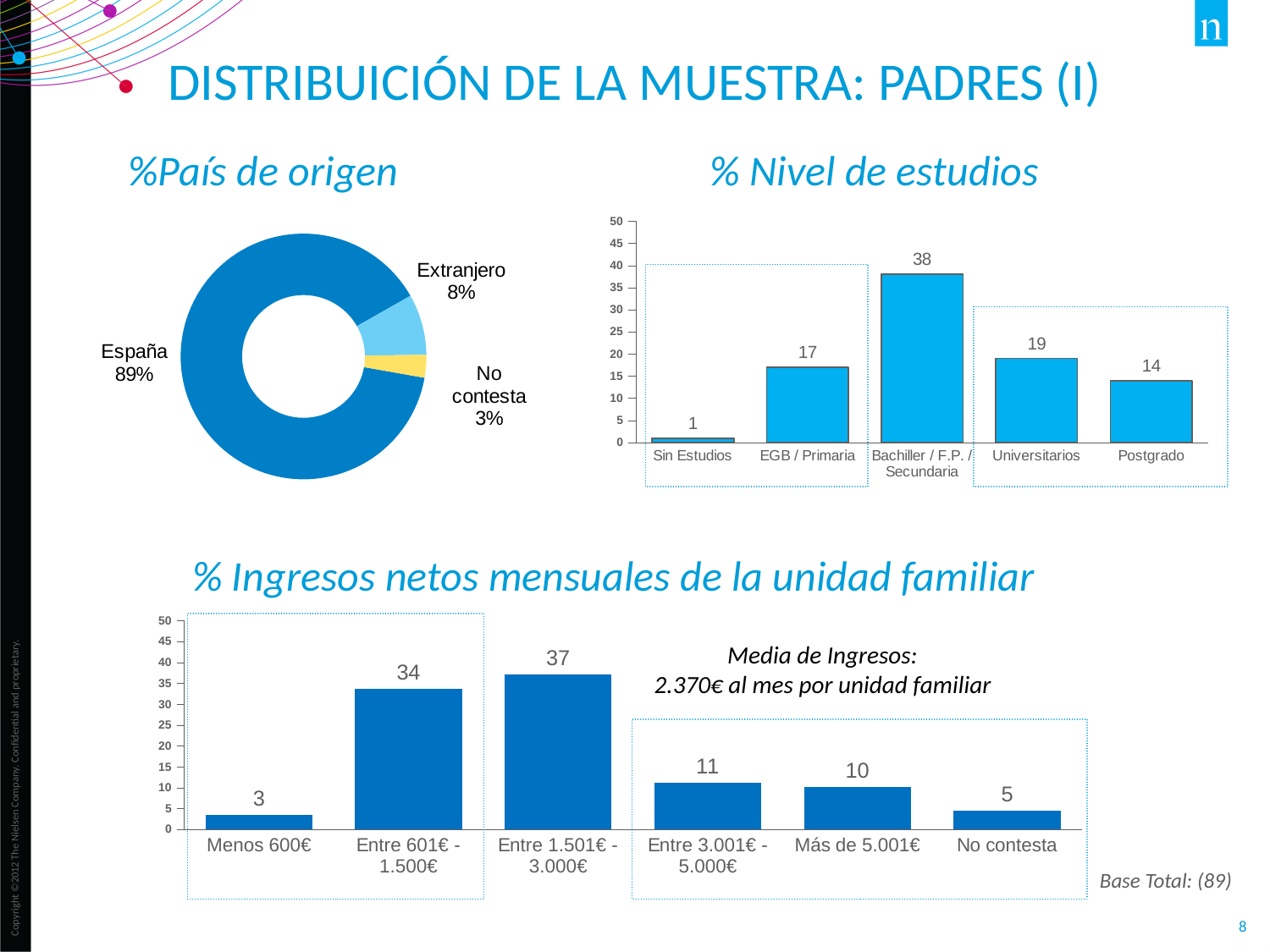
In the '% Nivel de estudios' chart, which category has the lowest value? Sin Estudios In the '% Ingresos netos mensuales de la unidad familiar' chart, which category has the highest value? Entre 1.501€ - 3.000€ What kind of chart is the '% Ingresos netos mensuales de la unidad familiar' chart? Bar chart In the '%País de origen' chart, what share does Extranjero have? 8% In the '% Nivel de estudios' chart, what is the value for Bachiller / F.P. / Secundaria? 38 In the '%País de origen' chart, what share does España have? 89% In the '% Ingresos netos mensuales de la unidad familiar' chart, what is the difference between Entre 1.501€ - 3.000€ and Entre 601€ - 1.500€? 3 What kind of chart is the '%País de origen' chart? Doughnut (pie) chart In the '% Ingresos netos mensuales de la unidad familiar' chart, which is larger: Menos 600€ or No contesta? No contesta In the '% Nivel de estudios' chart, what is the difference between Universitarios and Postgrado? 5 In the '% Nivel de estudios' chart, how many categories are shown? 5 In the '% Ingresos netos mensuales de la unidad familiar' chart, what is the value for Más de 5.001€? 10